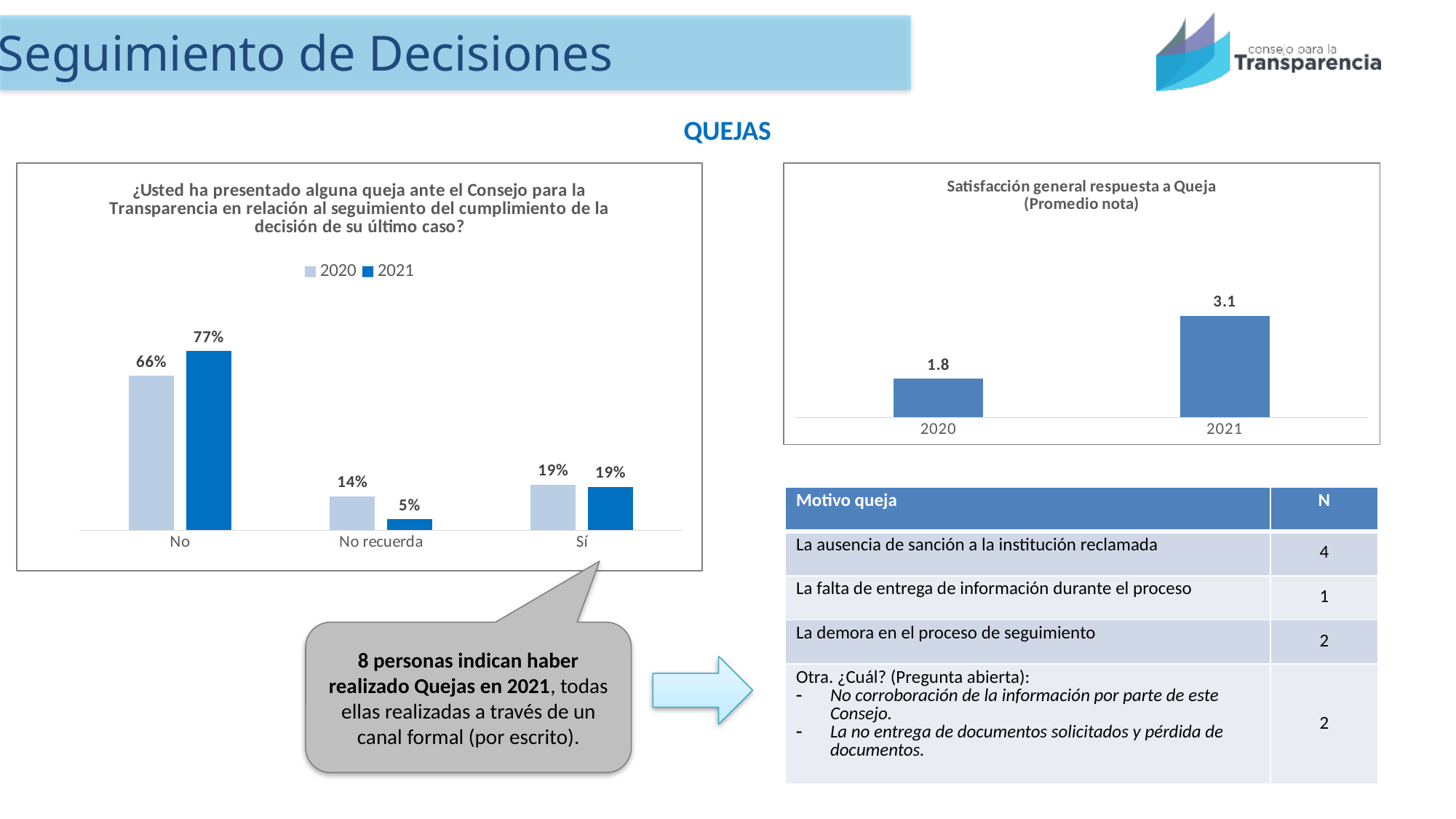
In the 'Satisfacción general respuesta a Queja' chart, what is the difference between the 2021 and 2020 values? 1.3 How many series does the legend of the left chart about whether a complaint was presented list? 2 In the left chart about whether a complaint was presented, is the 2020 value for 'No recuerda' larger or smaller than the 2021 value? larger How many categories are shown on the x axis of the left chart about whether a complaint was presented? 3 What kind of chart is the 'Satisfacción general respuesta a Queja' chart? bar chart In the left chart about whether a complaint was presented, which category has the lowest 2021 value? No recuerda In the 'Satisfacción general respuesta a Queja' chart, what is the value for 2021? 3.1 In the left chart about whether a complaint was presented, what is the 2020 value for 'No recuerda'? 14% In the left chart about whether a complaint was presented, what is the 2021 value for 'No'? 77% In the left chart about whether a complaint was presented, what is the 2021 value for 'Sí'? 19% In the left chart about whether a complaint was presented, which category has the highest 2021 value? No In the left chart about whether a complaint was presented, what is the difference between the 2021 and 2020 values for 'No'? 11 percentage points